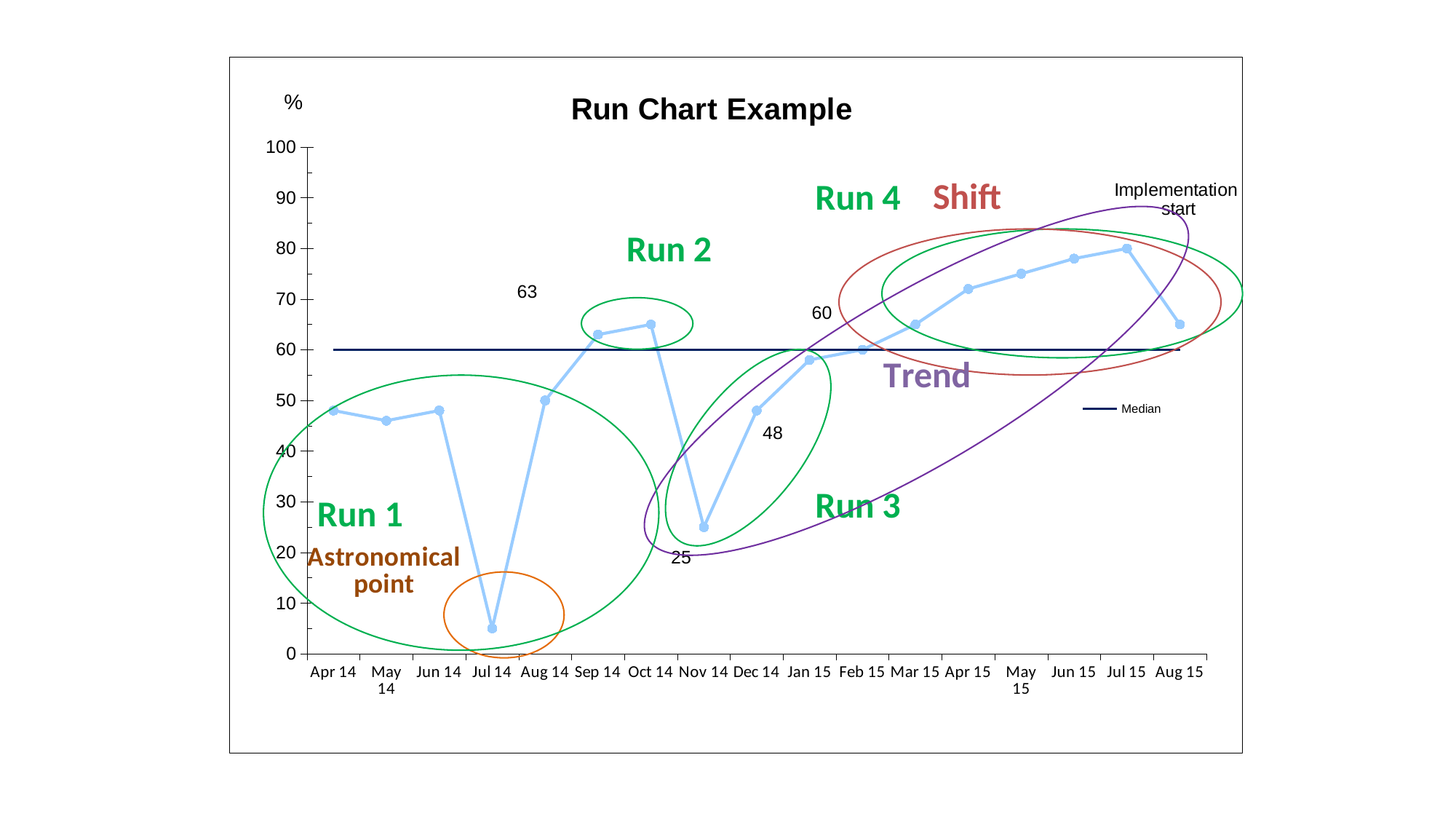
What is the value for Dec 14? 48 How many data points are plotted on the line? 17 Which month has the highest value? Jul 15 What is the value for Nov 14? 25 What kind of chart is shown on the slide? line chart Which month has the lowest value? Jul 14 Which entry does the legend list? Median What is the value for Feb 15? 60 Is the value for Jul 14 greater or less than 10? less What is the difference between the values for Sep 14 and Nov 14? 38 What is the value for Sep 14? 63 What is the title of the chart? Run Chart Example